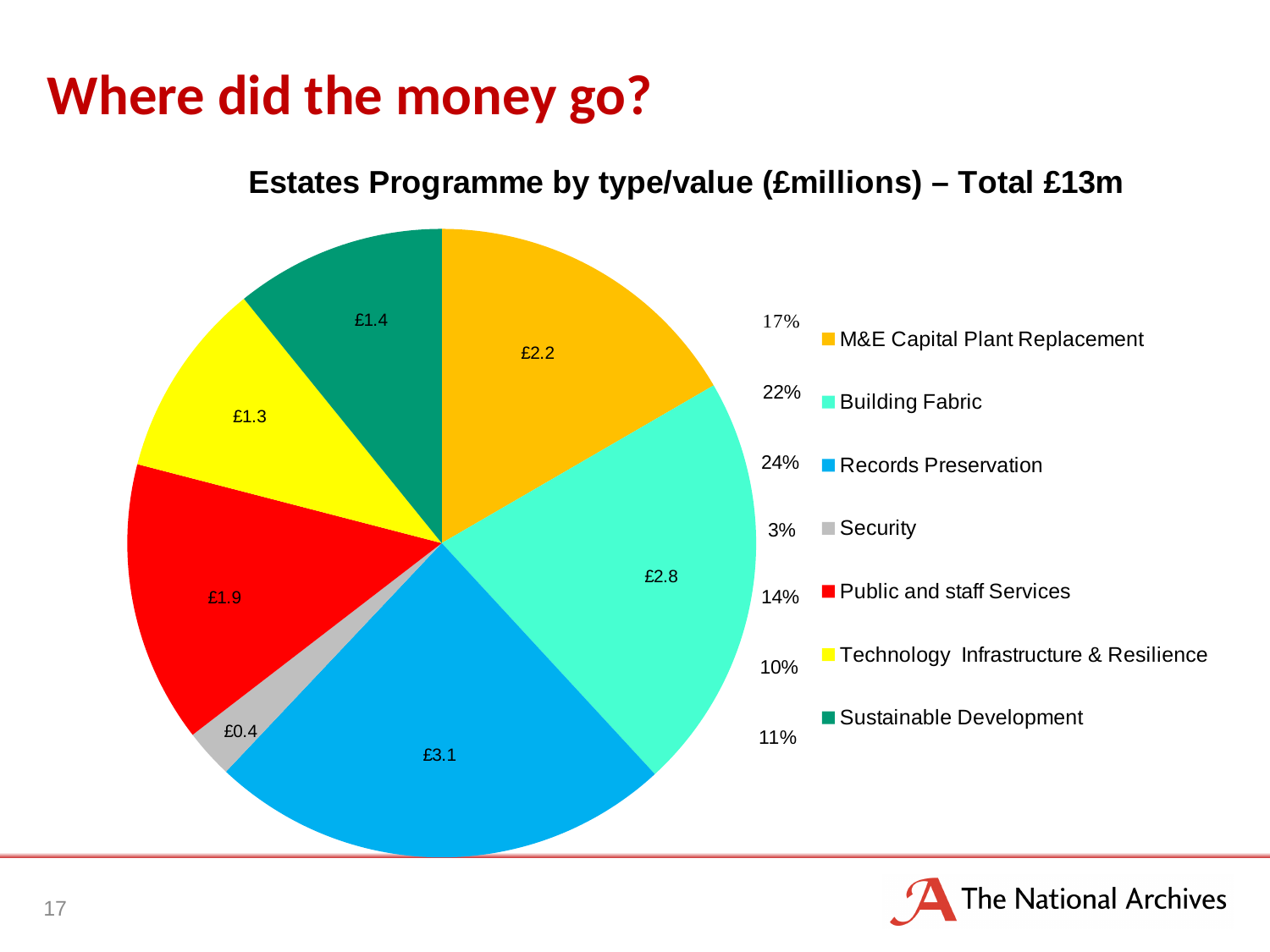
How many categories are shown in the pie chart? 7 What share of the pie does Building Fabric represent? 22% Which category has the largest slice of the pie? Records Preservation What is the value for Building Fabric? £2.8 What is the value for Security? £0.4 What is the value for Technology Infrastructure & Resilience? £1.3 What type of chart is shown on the slide? Pie chart Which is larger, the value for Public and staff Services or the value for Sustainable Development? Public and staff Services Which category has the smallest slice of the pie? Security What is the difference between the values for Records Preservation and M&E Capital Plant Replacement? £0.9 What is the value for Records Preservation? £3.1 What is the title of the chart? Estates Programme by type/value (£millions) – Total £13m